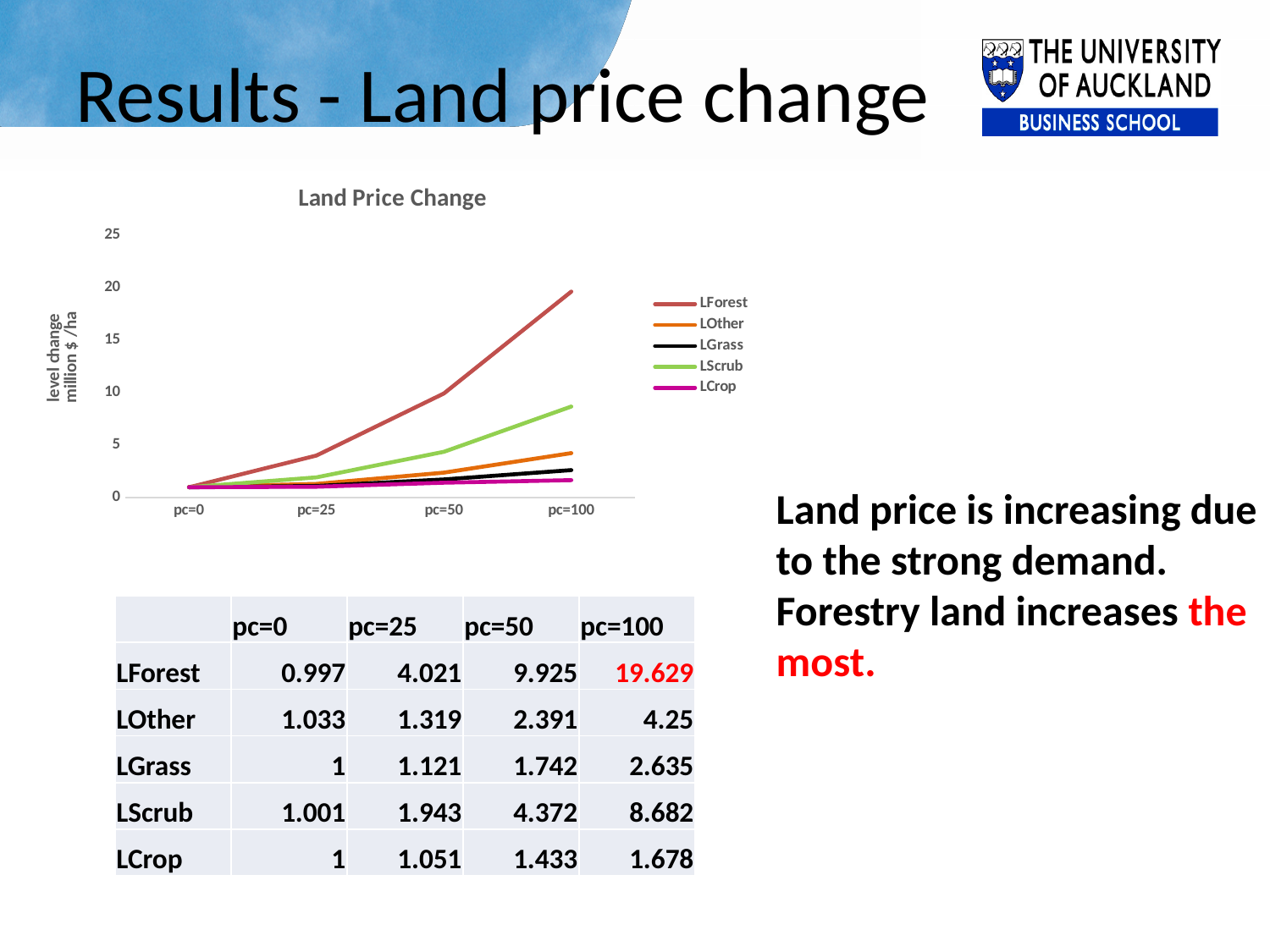
How many points are on the x axis of the Land Price Change chart? 4 In the Land Price Change chart, what is the difference between LForest and LScrub at pc=100? 10.947 How many series does the legend of the Land Price Change chart list? 5 What kind of chart is the Land Price Change chart? line chart In the Land Price Change chart, which is larger at pc=50: LOther or LGrass? LOther In the Land Price Change chart, what is the value for LForest at pc=100? 19.629 Which series has the highest value at pc=100 in the Land Price Change chart? LForest Which series has the lowest value at pc=100 in the Land Price Change chart? LCrop In the Land Price Change chart, what is the value for LScrub at pc=50? 4.372 In the Land Price Change chart, what is the value for LOther at pc=100? 4.25 Does the LForest series in the Land Price Change chart rise or fall from pc=0 to pc=100? rise Is the value for LForest at pc=100 in the Land Price Change chart greater or less than 15? greater